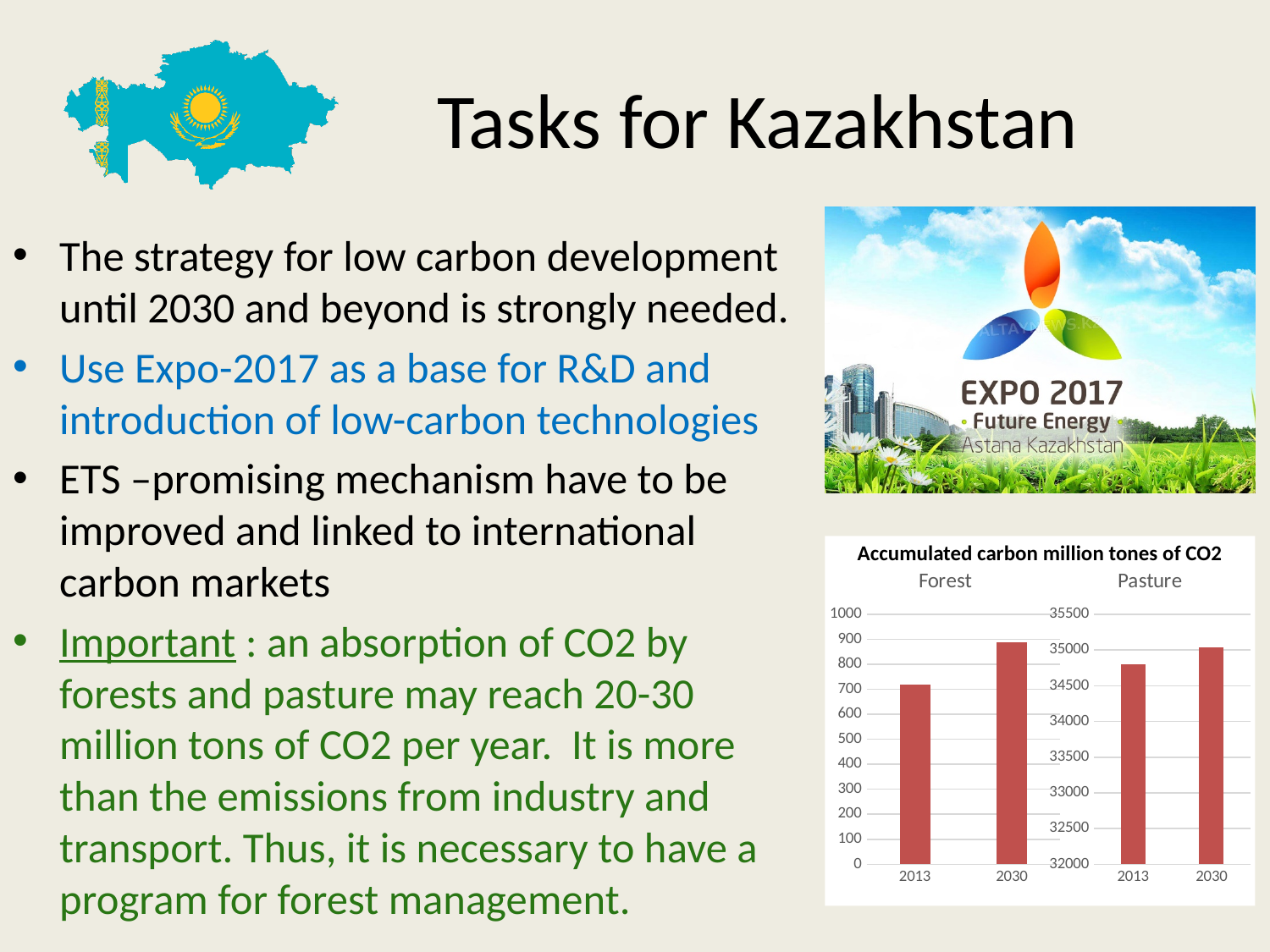
In the Pasture chart, which year has the lower bar? 2013 In the Pasture chart, is the value for 2013 greater or less than 35000? less In the Pasture chart, do the values rise or fall from 2013 to 2030? rise What kind of chart is used for the Forest chart? bar chart In the Forest chart, is the value for 2013 greater or less than 800? less How many bars are shown in the Forest chart? 2 What is the overall title above the Forest and Pasture charts? Accumulated carbon million tones of CO2 In the Pasture chart, is the value for 2013 greater or less than 34500? greater How many bars are shown in the Pasture chart? 2 In the Forest chart, which year has the higher bar, 2013 or 2030? 2030 In the Forest chart, do the values rise or fall from 2013 to 2030? rise